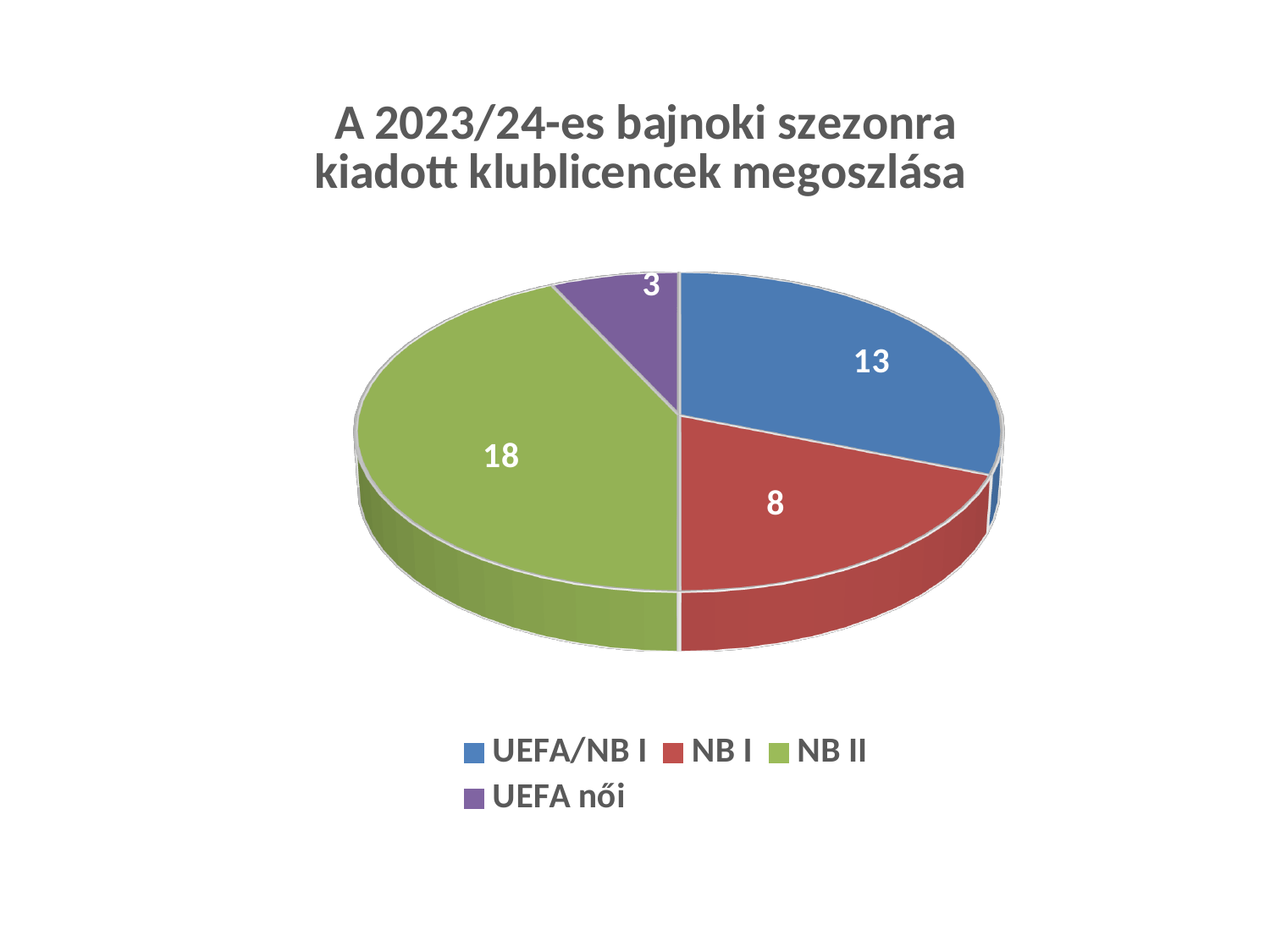
What is the total of all slices in the pie chart? 42 What is the difference between the values for NB II and UEFA/NB I? 5 What is the value for UEFA/NB I? 13 What is the value for UEFA női? 3 What is the value for NB I? 8 What is the value for NB II? 18 Which category has the smallest slice? UEFA női What is the title of the chart? A 2023/24-es bajnoki szezonra kiadott klublicencek megoszlása How many categories does the pie chart have? 4 Which is larger, the value for UEFA/NB I or the value for NB I? UEFA/NB I What kind of chart is shown on the slide? pie chart Which category has the largest slice? NB II